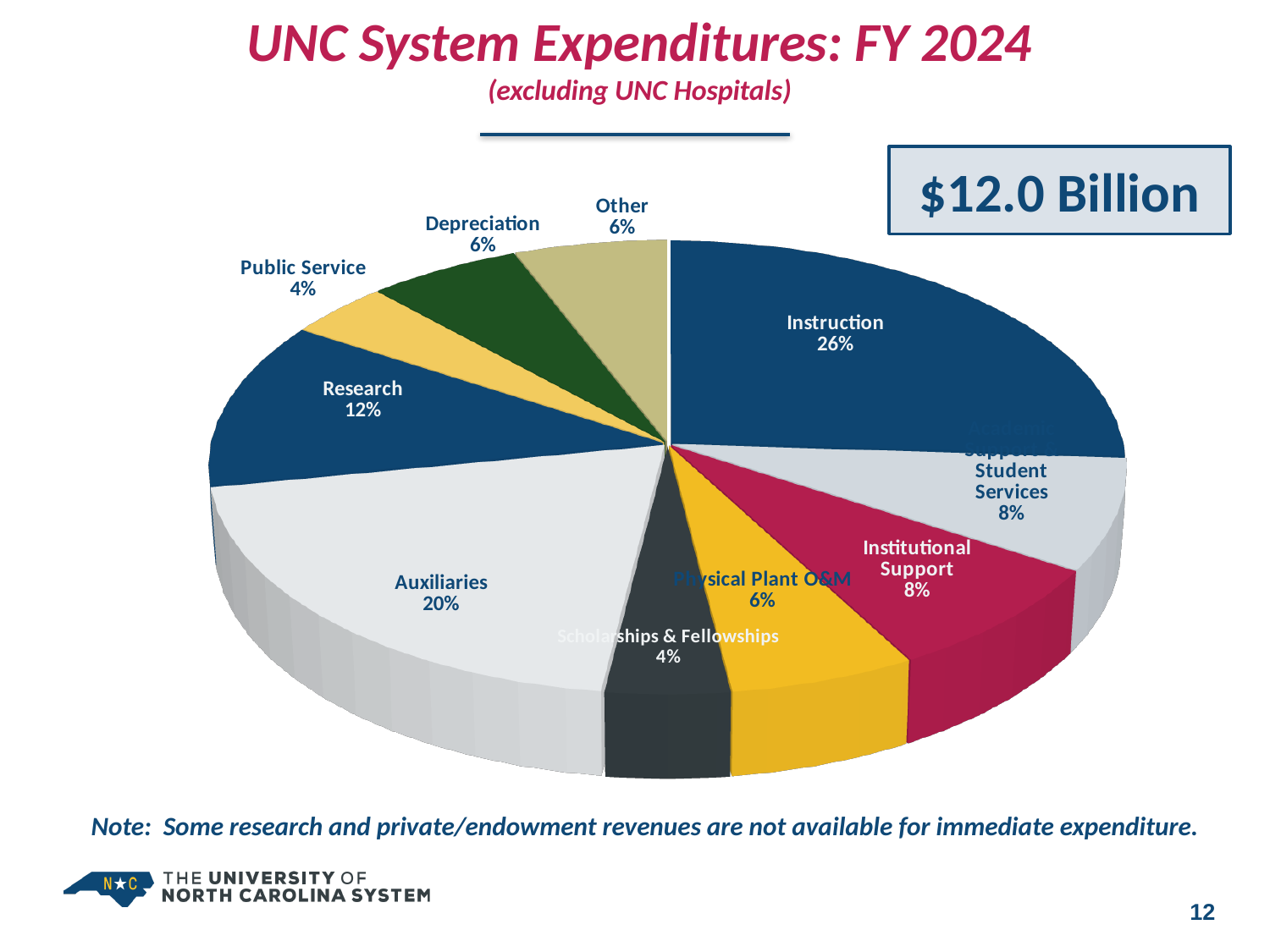
How many slices does the pie chart have? 10 What kind of chart is shown on the slide? Pie chart Which category has the largest share of expenditures? Instruction What percentage of UNC System expenditures in FY 2024 goes to Instruction? 26% What percentage is shown for Physical Plant O&M? 6% How many percentage points larger is Instruction's share than Auxiliaries' share? 6 percentage points What share of the pie does Auxiliaries represent? 20% What percentage is shown for Public Service? 4% Which has a larger share, Research or Depreciation? Research What percentage is shown for Research? 12% What total expenditure amount is shown in the box on the slide? $12.0 Billion How many percentage points larger is Auxiliaries' share than Research's share? 8 percentage points